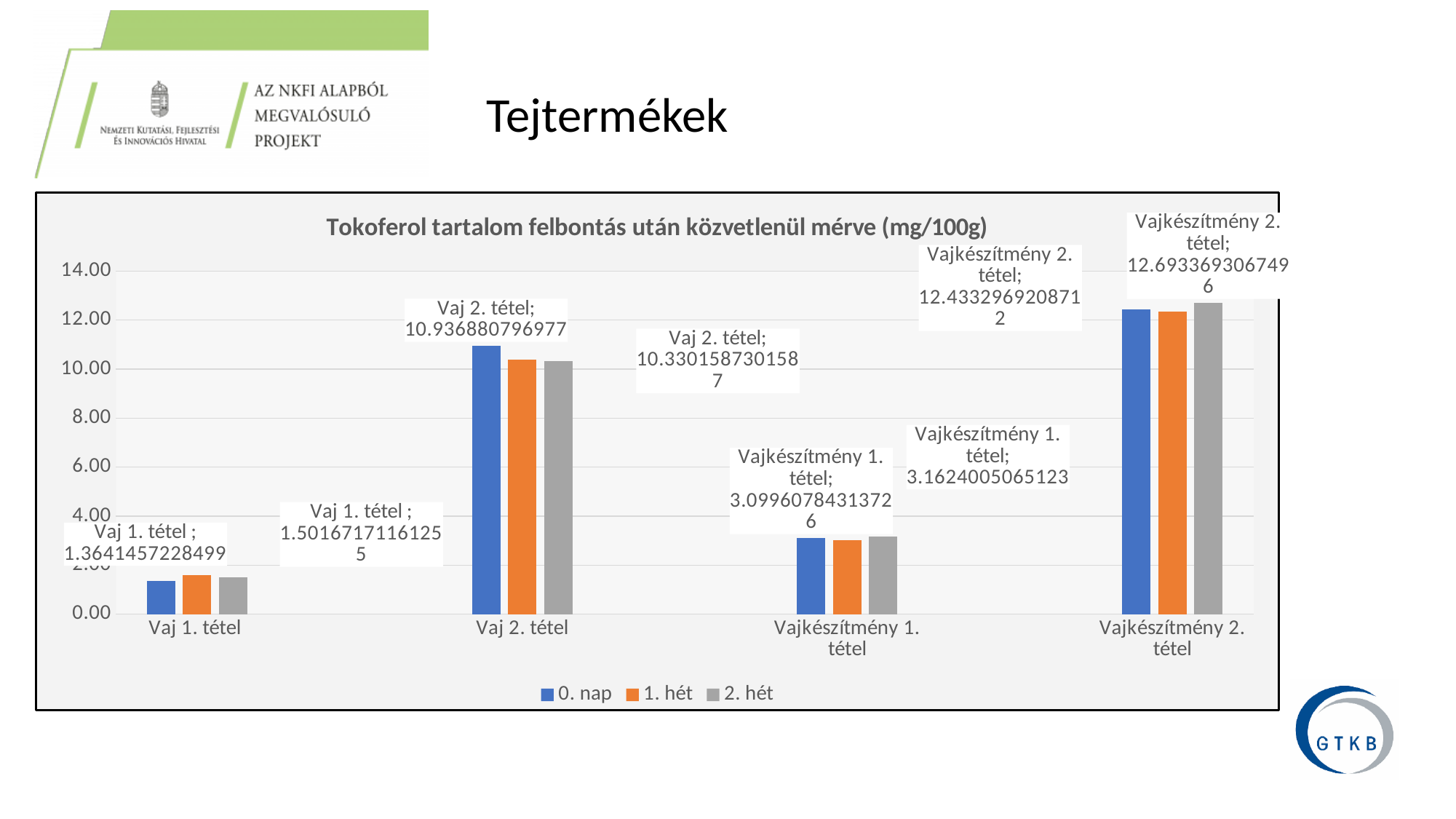
Which category has the lowest tocopherol values? Vaj 1. tétel Is the 2. hét value for Vajkészítmény 2. tétel greater or less than 12.00? greater Which series are listed in the legend? 0. nap, 1. hét, 2. hét What kind of chart is shown on the slide? bar chart What is the title of the chart? Tokoferol tartalom felbontás után közvetlenül mérve (mg/100g) How many series does the legend list? 3 What is the 0. nap value for Vaj 2. tétel? 10.936880796977 How many product categories are shown on the x axis? 4 What is the 0. nap value for Vaj 1. tétel? 1.3641457228499 Which category has the highest tocopherol values? Vajkészítmény 2. tétel For the 0. nap series, which is larger: Vaj 2. tétel or Vajkészítmény 1. tétel? Vaj 2. tétel Is the 0. nap value for Vajkészítmény 1. tétel greater or less than 4.00? less